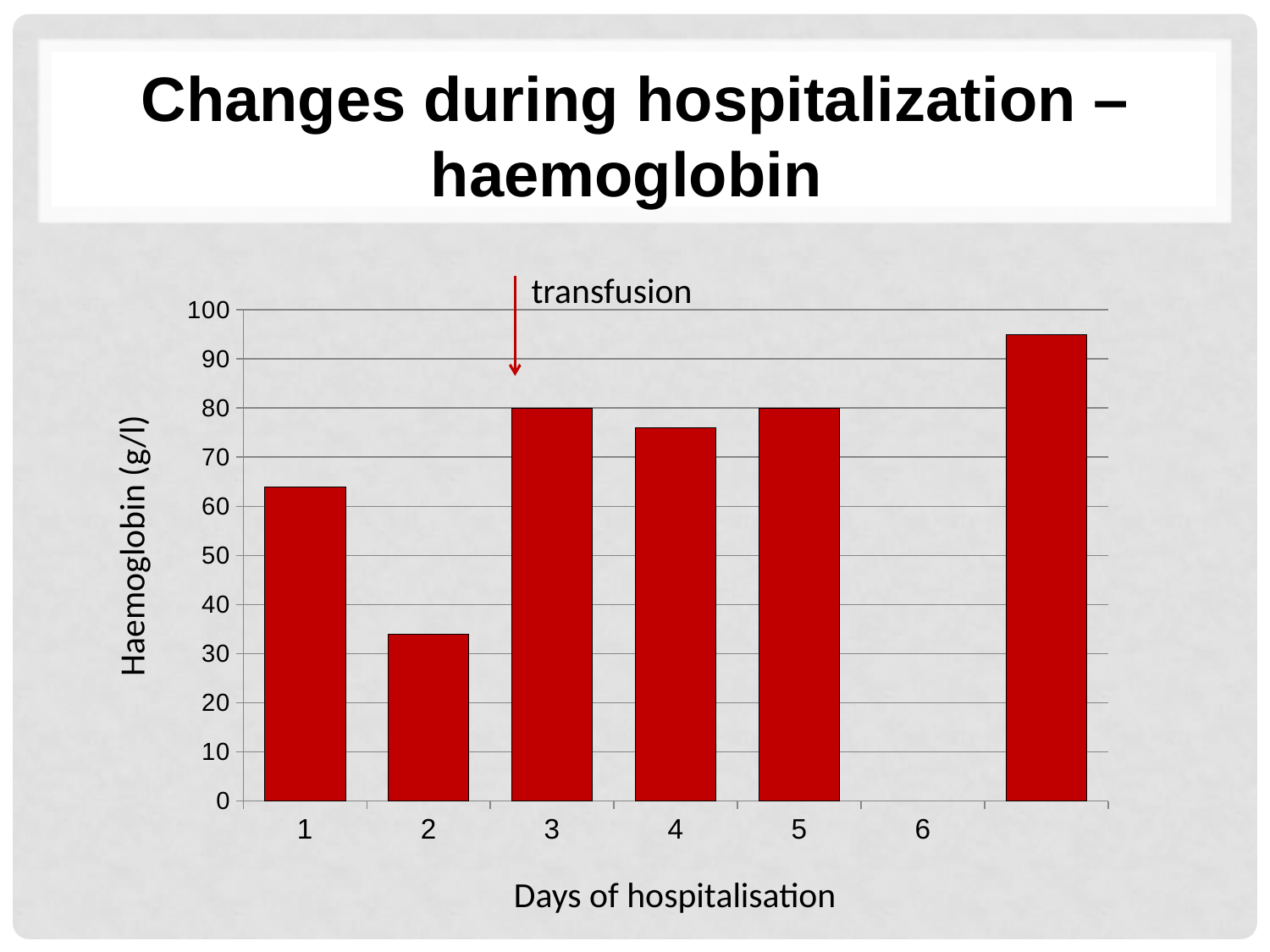
Which has the higher haemoglobin value, day 1 or day 2? day 1 Does the haemoglobin value rise or fall from day 1 to day 2? fall Which has the higher haemoglobin value, day 3 or day 4? day 3 Is the haemoglobin value on day 4 greater or less than 70? greater What is the haemoglobin value on day 5 of hospitalisation? 80 What kind of chart is shown on the slide? bar chart Which day of hospitalisation has the lowest haemoglobin value? 2 What event is annotated with an arrow above the day 3 bar? transfusion What is the haemoglobin value on day 3 of hospitalisation? 80 Is the haemoglobin value on day 1 greater or less than 60? greater Is the haemoglobin value on day 2 greater or less than 40? less What is the label of the y axis? Haemoglobin (g/l)